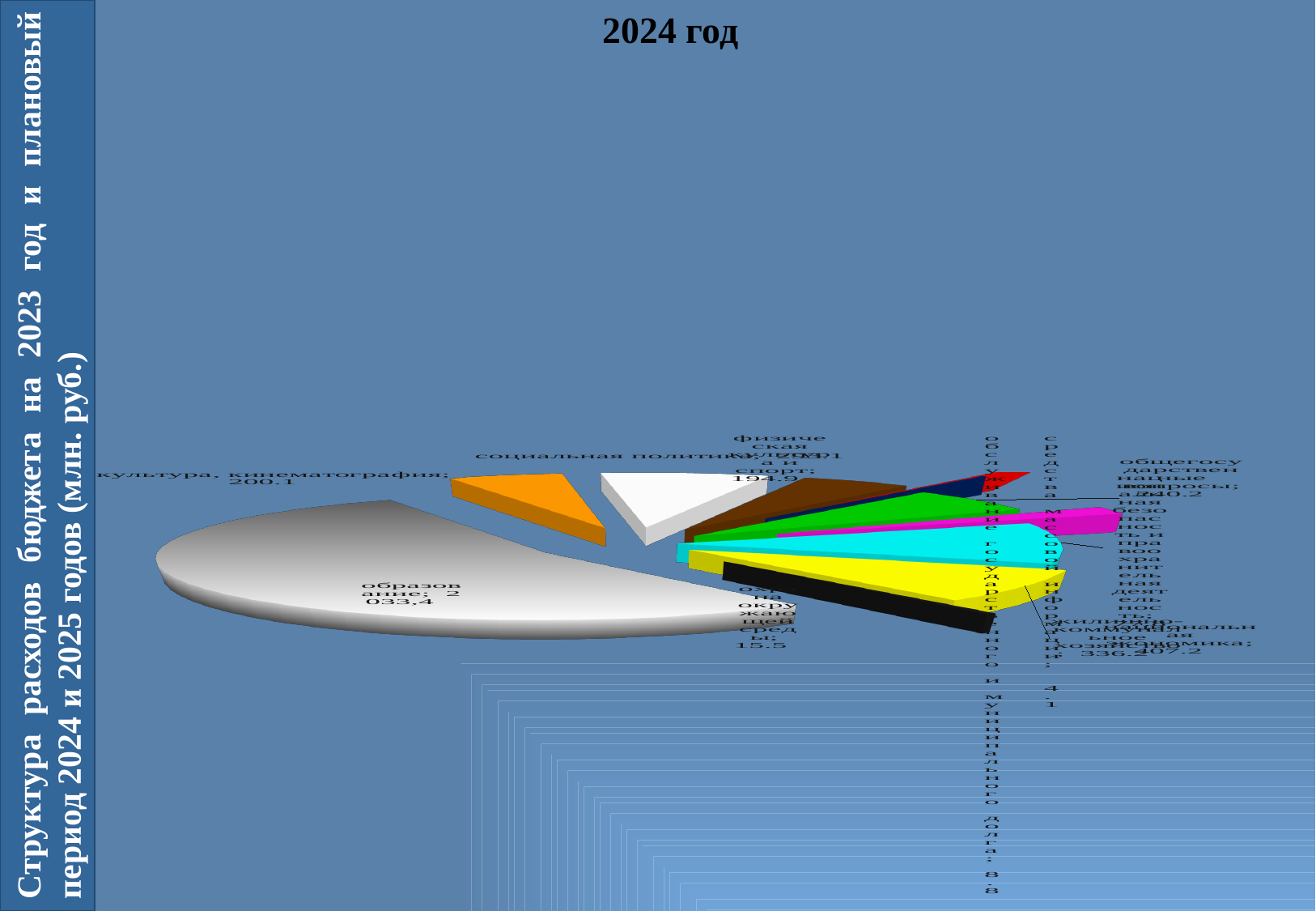
What is the title of the chart? 2024 год What is the value for культура, кинематография? 200.1 What is the value for образование? 2 033,4 What is the difference between культура, кинематография and охрана окружающей среды? 184.6 Which is larger, образование or культура, кинематография? образование What is the value for физическая культура и спорт? 194.9 Which category has the largest slice of the pie? образование In what units are the values given, according to the slide's side title? млн. руб. What is the difference between культура, кинематография and физическая культура и спорт? 5.2 Which is larger, культура, кинематография or физическая культура и спорт? культура, кинематография What is the value for охрана окружающей среды? 15.5 What kind of chart is shown on the slide? pie chart